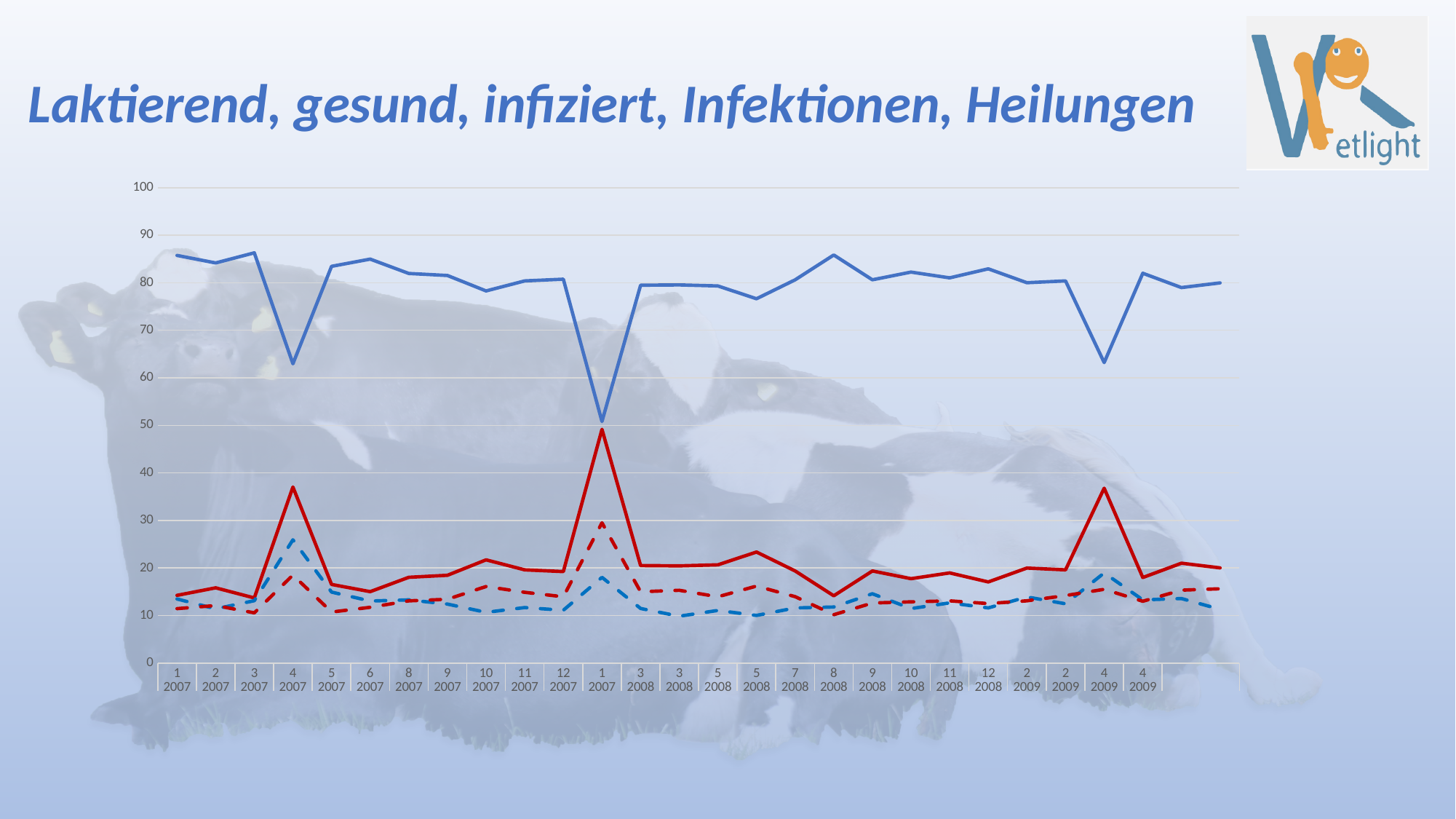
What kind of chart is shown on the slide? line chart At 4 2009, which line has the larger value: the solid red line or the dashed red line? the solid red line Does the solid red line rise or fall between 3 2007 and 4 2007? rise What is the title of the slide's chart? Laktierend, gesund, infiziert, Infektionen, Heilungen How many lines are plotted in the chart? 4 Is the value of the dashed blue line at 4 2007 greater or less than 20? greater Is the value of the solid blue line at 4 2007 greater or less than 70? less Is the value of the solid red line at 8 2008 greater or less than 20? less